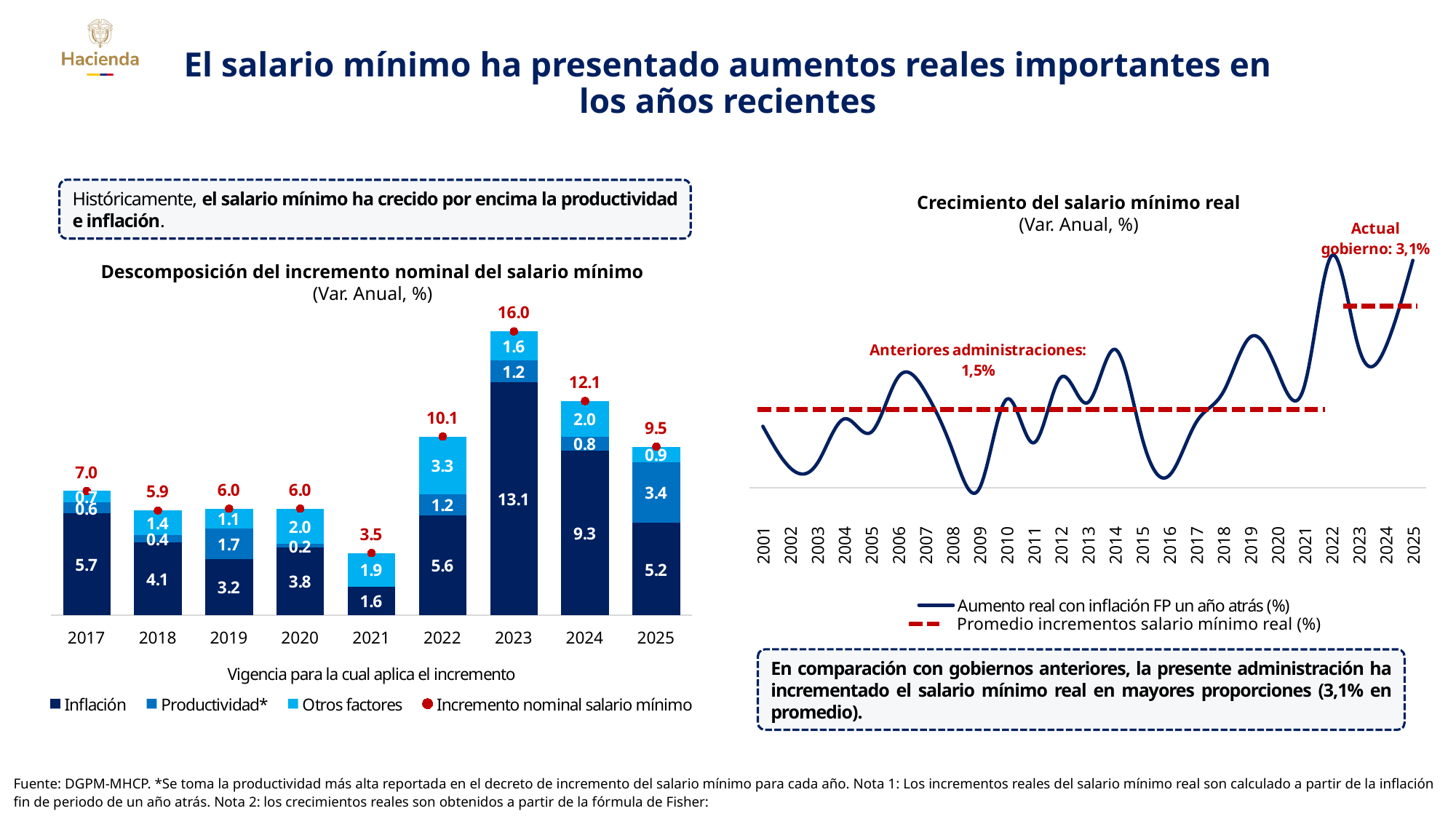
In the chart 'Descomposición del incremento nominal del salario mínimo', which year has the larger Productividad* value, 2019 or 2025? 2025 In the chart 'Descomposición del incremento nominal del salario mínimo', what is the difference between the Incremento nominal salario mínimo in 2023 and in 2024? 3.9 How many entries does the legend of the chart 'Descomposición del incremento nominal del salario mínimo' list? 4 In the chart 'Descomposición del incremento nominal del salario mínimo', what is the Inflación value for 2023? 13.1 In the chart 'Descomposición del incremento nominal del salario mínimo', what is the Otros factores value for 2022? 3.3 What kind of chart is 'Crecimiento del salario mínimo real'? Line chart In the chart 'Descomposición del incremento nominal del salario mínimo', which year has the highest Incremento nominal salario mínimo? 2023 In the chart 'Descomposición del incremento nominal del salario mínimo', which year has the lowest Incremento nominal salario mínimo? 2021 In the chart 'Crecimiento del salario mínimo real', what is the average real minimum wage increase shown for 'Anteriores administraciones'? 1,5% In the chart 'Crecimiento del salario mínimo real', what is the average real minimum wage increase shown for 'Actual gobierno'? 3,1% In the chart 'Descomposición del incremento nominal del salario mínimo', what is the Incremento nominal salario mínimo for 2025? 9.5 How many years are shown on the x axis of the chart 'Descomposición del incremento nominal del salario mínimo'? 9